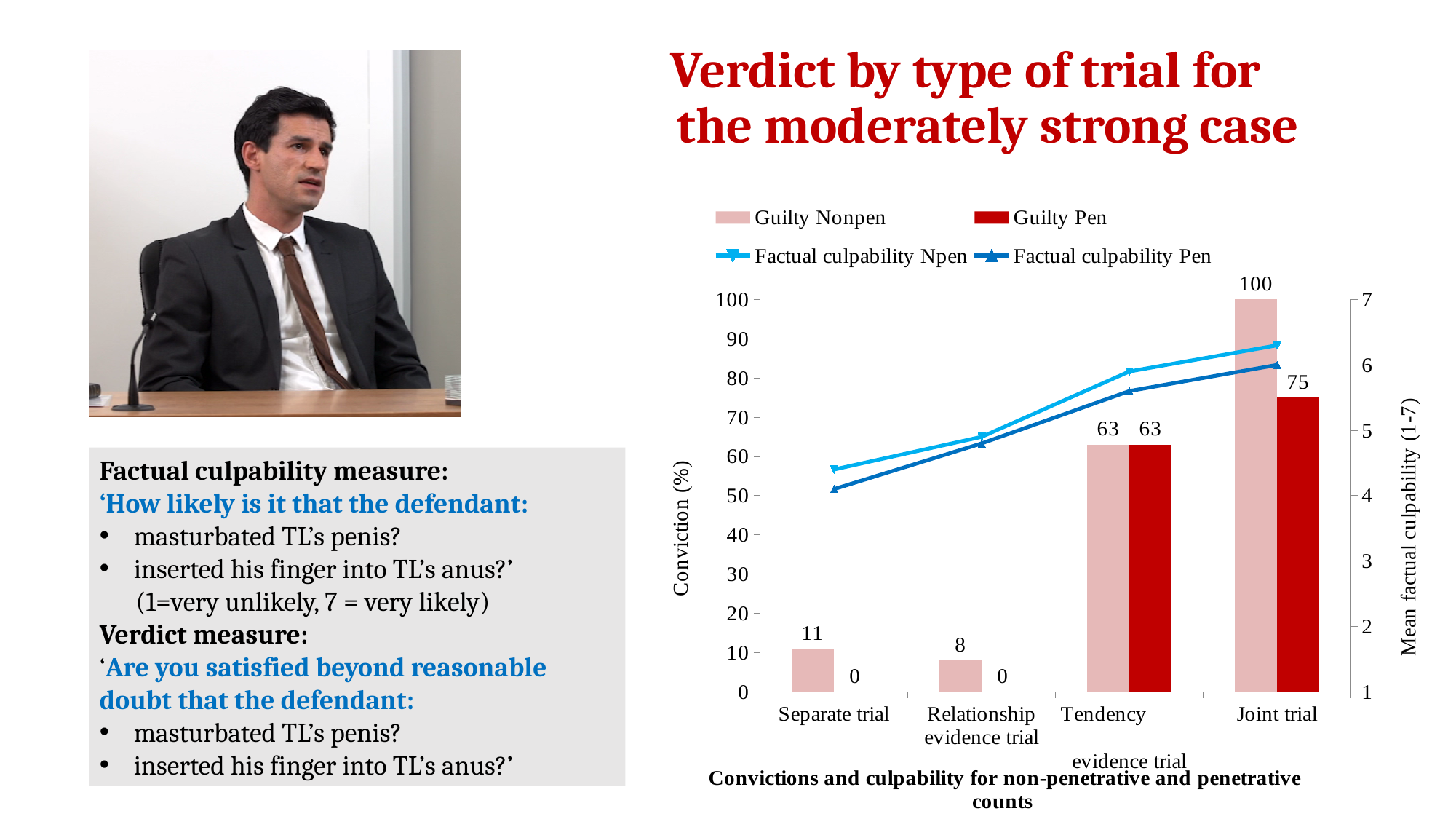
What is the Guilty Pen conviction percentage for the Joint trial? 75 What is the difference between the Guilty Nonpen and Guilty Pen values for the Joint trial? 25 Is the Factual culpability Npen value for the Joint trial greater or less than 6 on the right-hand axis? greater How many series does the legend list? 4 What is the Guilty Nonpen conviction percentage for the Separate trial? 11 What is the Guilty Pen value for the Tendency evidence trial? 63 How many trial types are shown on the x axis? 4 Which trial type has the highest Guilty Nonpen conviction percentage? Joint trial Which is larger for the Separate trial: Guilty Nonpen or Guilty Pen? Guilty Nonpen What is the label of the right-hand vertical axis? Mean factual culpability (1-7) Does the Factual culpability Pen line rise or fall from Separate trial to Joint trial? rise What is the Guilty Nonpen value for the Relationship evidence trial? 8